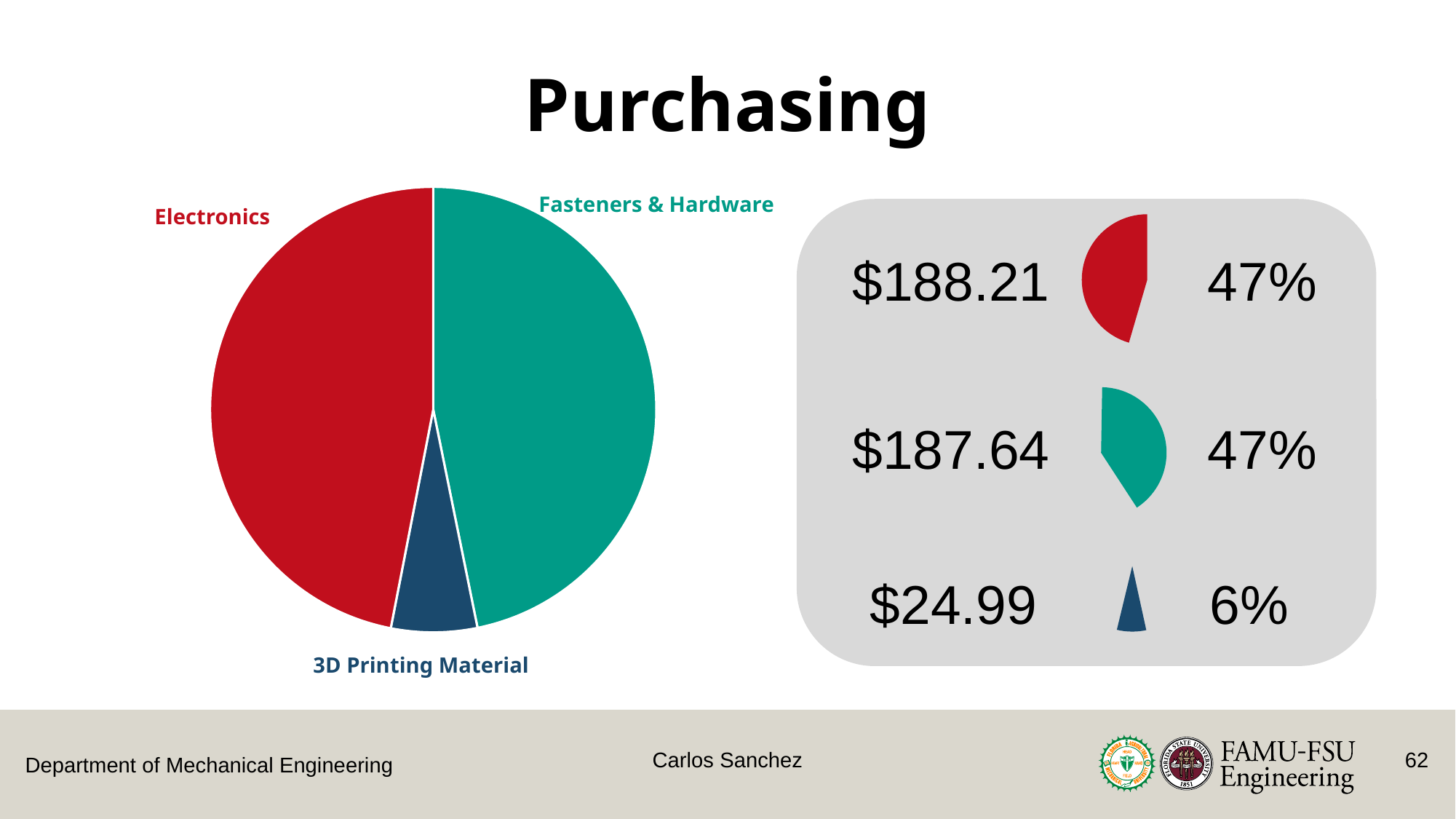
What is the dollar value for 3D Printing Material? $24.99 Which category has the smallest slice of the pie? 3D Printing Material What kind of chart is shown on the slide? pie chart What is the dollar value for Electronics? $188.21 What share of the pie does Electronics represent? 47% What is the difference between the Electronics value and the 3D Printing Material value? $163.22 How many slices does the pie chart have? 3 What is the dollar value for Fasteners & Hardware? $187.64 Which is larger, the value for Electronics or the value for 3D Printing Material? Electronics What colour is the Fasteners & Hardware slice? teal What is the total of the three values shown for the pie chart? $400.84 What share of the pie does 3D Printing Material represent? 6%